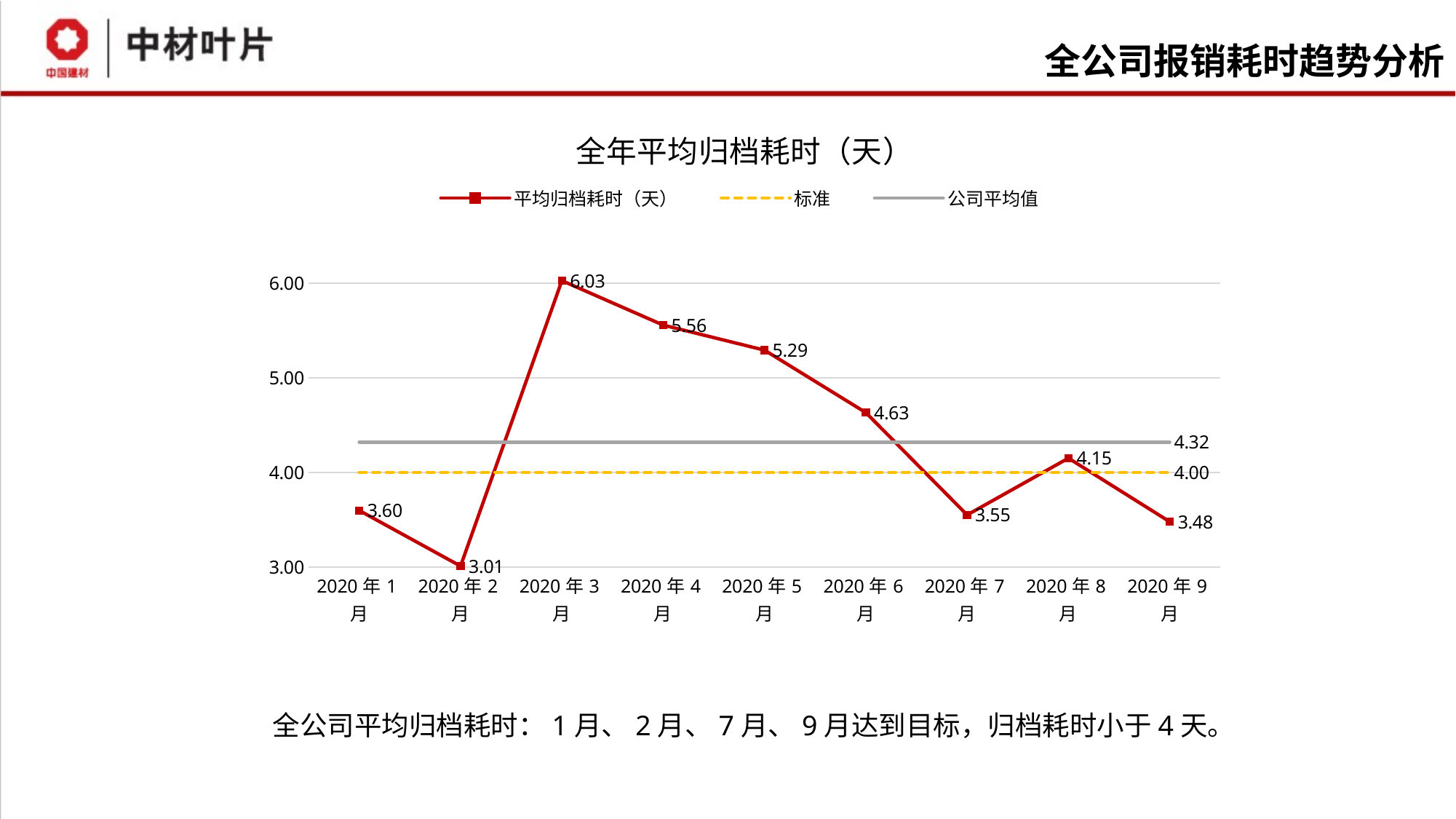
What value is shown for the 公司平均值 line? 4.32 Which month has the highest 平均归档耗时 (天)? 2020年3月 Which is larger, the 平均归档耗时 value for 2020年4月 or for 2020年6月? 2020年4月 What kind of chart is shown on the slide? line chart Is the 平均归档耗时 value for 2020年5月 greater or less than 5.00? greater What is the difference between the 平均归档耗时 values for 2020年3月 and 2020年2月? 3.02 How many series does the legend list? 3 What is the title of the chart? 全年平均归档耗时（天） How many months are plotted on the x axis? 9 What is the 平均归档耗时 (天) value for 2020年3月? 6.03 Which month has the lowest 平均归档耗时 (天)? 2020年2月 What is the 平均归档耗时 (天) value for 2020年9月? 3.48